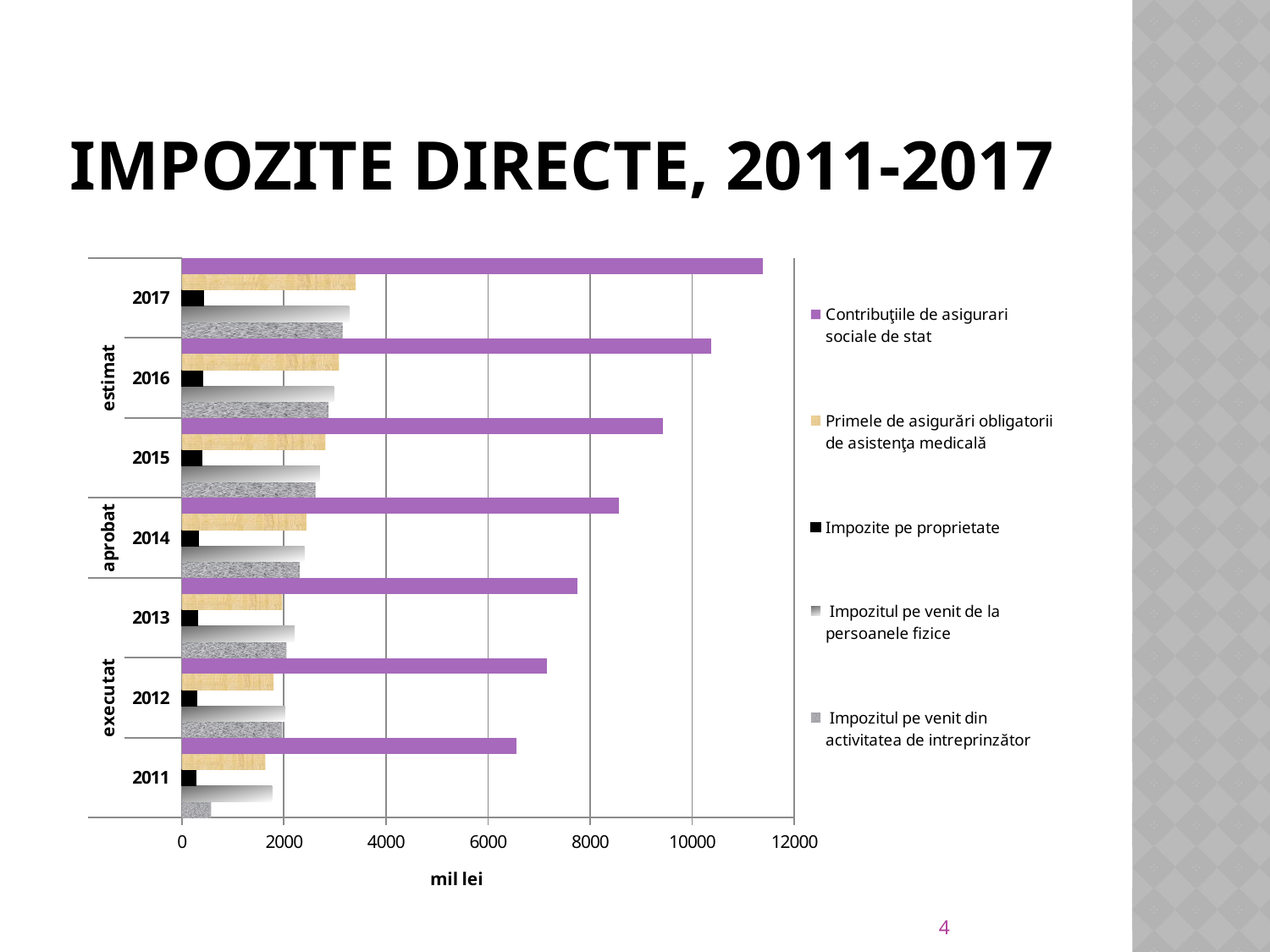
Do the values for Contribuţiile de asigurari sociale de stat rise or fall from 2011 to 2017? rise Which is larger in 2017: Primele de asigurări obligatorii de asistenţa medicală or Impozite pe proprietate? Primele de asigurări obligatorii de asistenţa medicală How many series does the legend list? 5 Is the value for Contribuţiile de asigurari sociale de stat in 2017 greater or less than 10000? greater Is the value for Contribuţiile de asigurari sociale de stat in 2012 greater or less than 6000? greater Which series has the lowest value in 2017? Impozite pe proprietate Is the value for Impozite pe proprietate in 2017 greater or less than 2000? less How many years are shown on the vertical axis of the chart? 7 Which year has the lowest value for Contribuţiile de asigurari sociale de stat? 2011 What kind of chart is shown on the slide? bar chart Which year has the highest value for Contribuţiile de asigurari sociale de stat? 2017 What unit is given on the horizontal axis label of the chart? mil lei